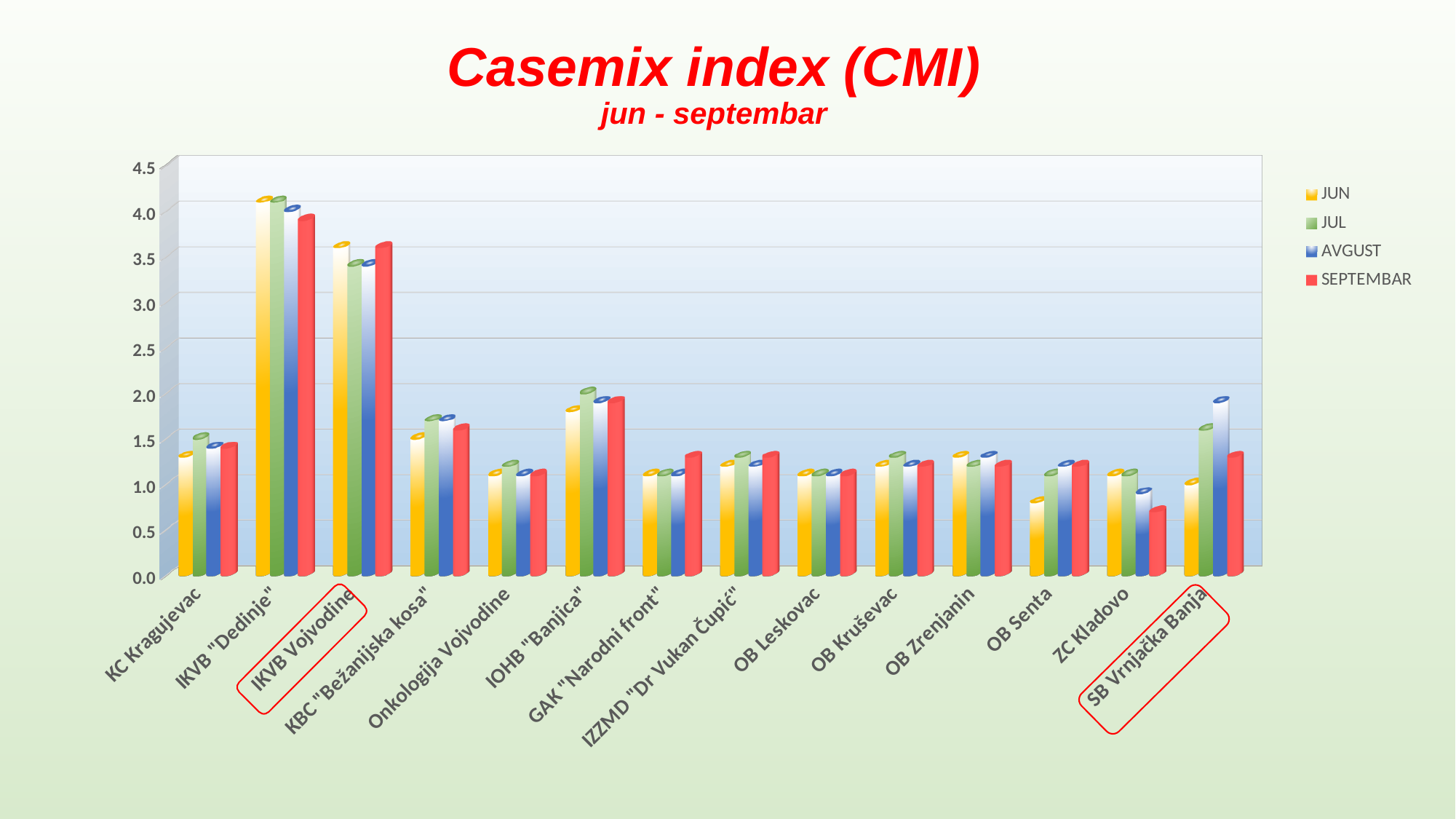
Which hospital has the lowest SEPTEMBAR value? ZC Kladovo Is the SEPTEMBAR value for ZC Kladovo greater or less than 1.0? less Which hospital has the highest JUN value? IKVB "Dedinje" Do the values for ZC Kladovo rise or fall from JUN to SEPTEMBAR? fall What kind of chart is shown on the slide? Bar chart How many hospitals (categories) are shown on the x axis? 14 Is the SEPTEMBAR value for IKVB "Dedinje" greater or less than 3.5? greater What is the title of the chart? Casemix index (CMI) How many series does the legend list? 4 Is the JUL value for IOHB "Banjica" greater or less than 1.5? greater Which is larger in JUL: IKVB "Dedinje" or IKVB Vojvodine? IKVB "Dedinje"